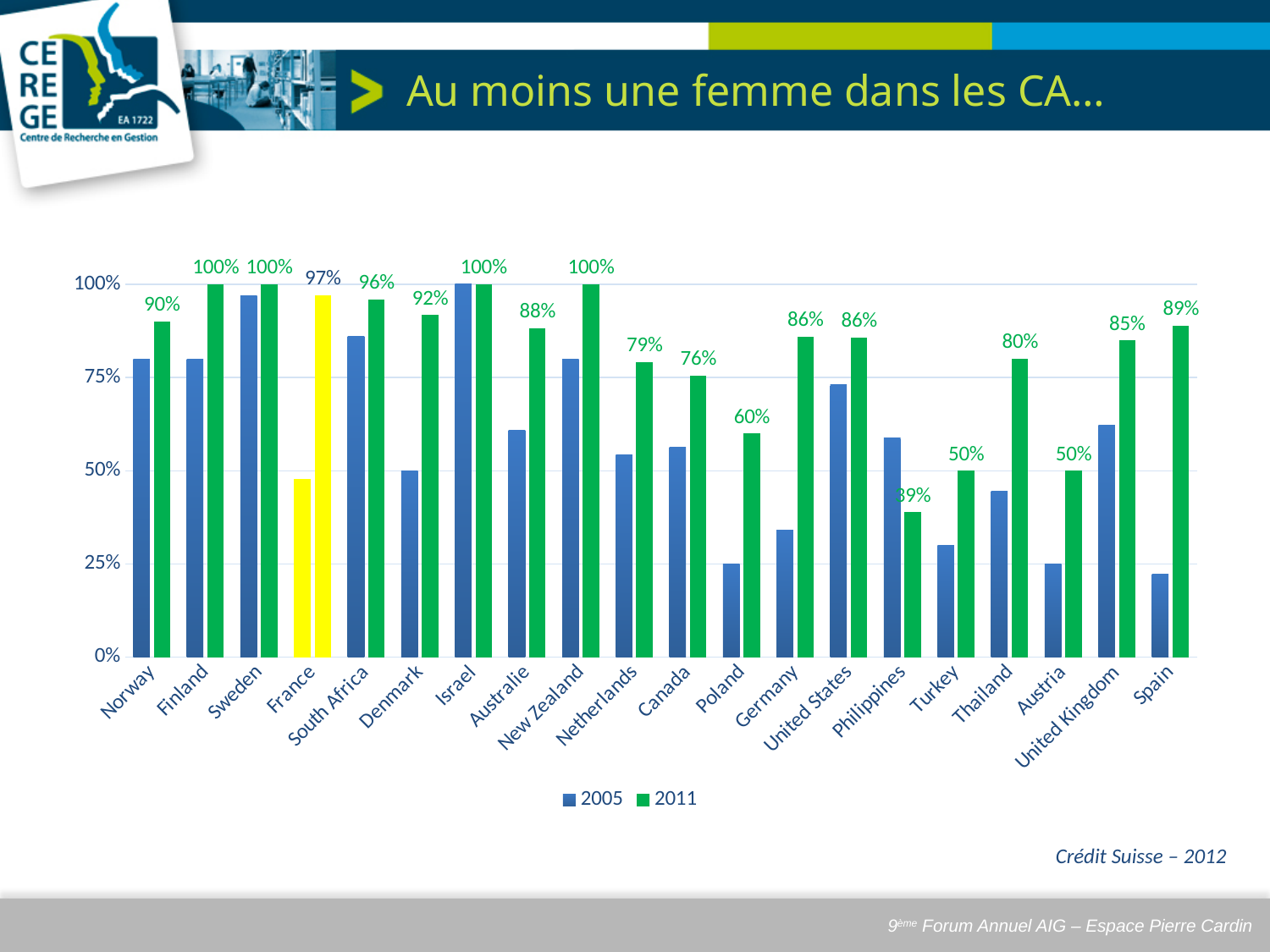
Is the 2005 value for Spain greater or less than 25%? less Which is larger, the 2011 value for Spain or the 2011 value for the United Kingdom? Spain How many countries are shown on the x axis? 20 How many series does the legend list? 2 Which country has the lowest 2011 value? Philippines What is the 2011 value for the Philippines? 39% What is the 2011 value for France? 97% What is the 2011 value for Poland? 60% What is the difference between the 2011 values for Norway and Canada? 14 percentage points Which country's bars are highlighted in yellow? France Is the 2005 value for Norway greater or less than 75%? greater What kind of chart is shown on the slide? Bar chart